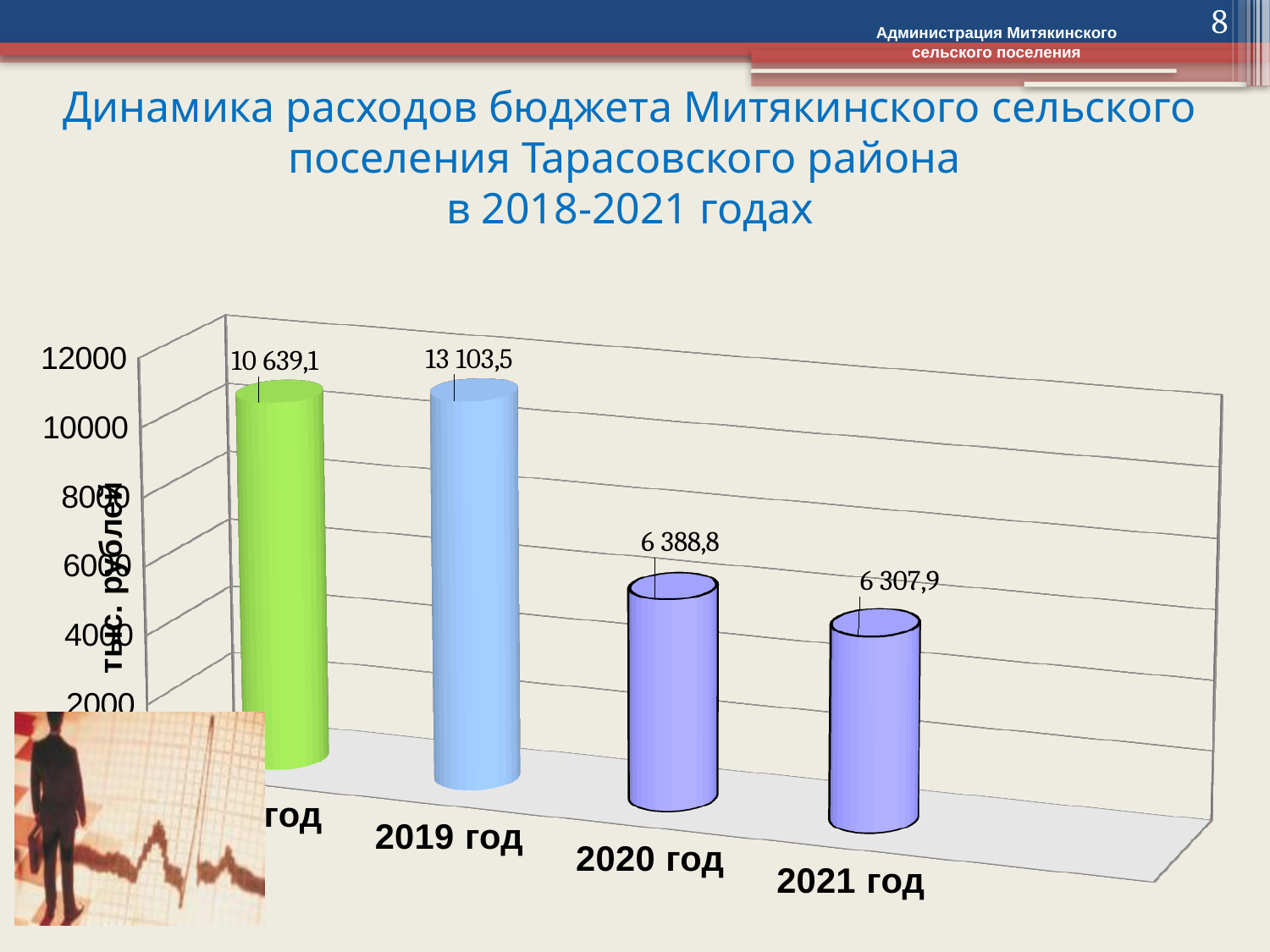
What is the value for 2021 год? 6 307,9 Which year has the highest value? 2019 год Which is larger: the value for 2019 год or the value of the green bar on the left? 2019 год Which year has the lowest value? 2021 год How many bars are shown in the chart? 4 What kind of chart is shown on the slide? bar chart Do the values rise or fall from 2019 год to 2021 год? fall What is the difference between the values for 2020 год and 2021 год? 80,9 What is the difference between the values for 2019 год and 2020 год? 6 714,7 What is the value for 2020 год? 6 388,8 What is the value shown on the green bar (the first bar on the left)? 10 639,1 What is the value for 2019 год? 13 103,5